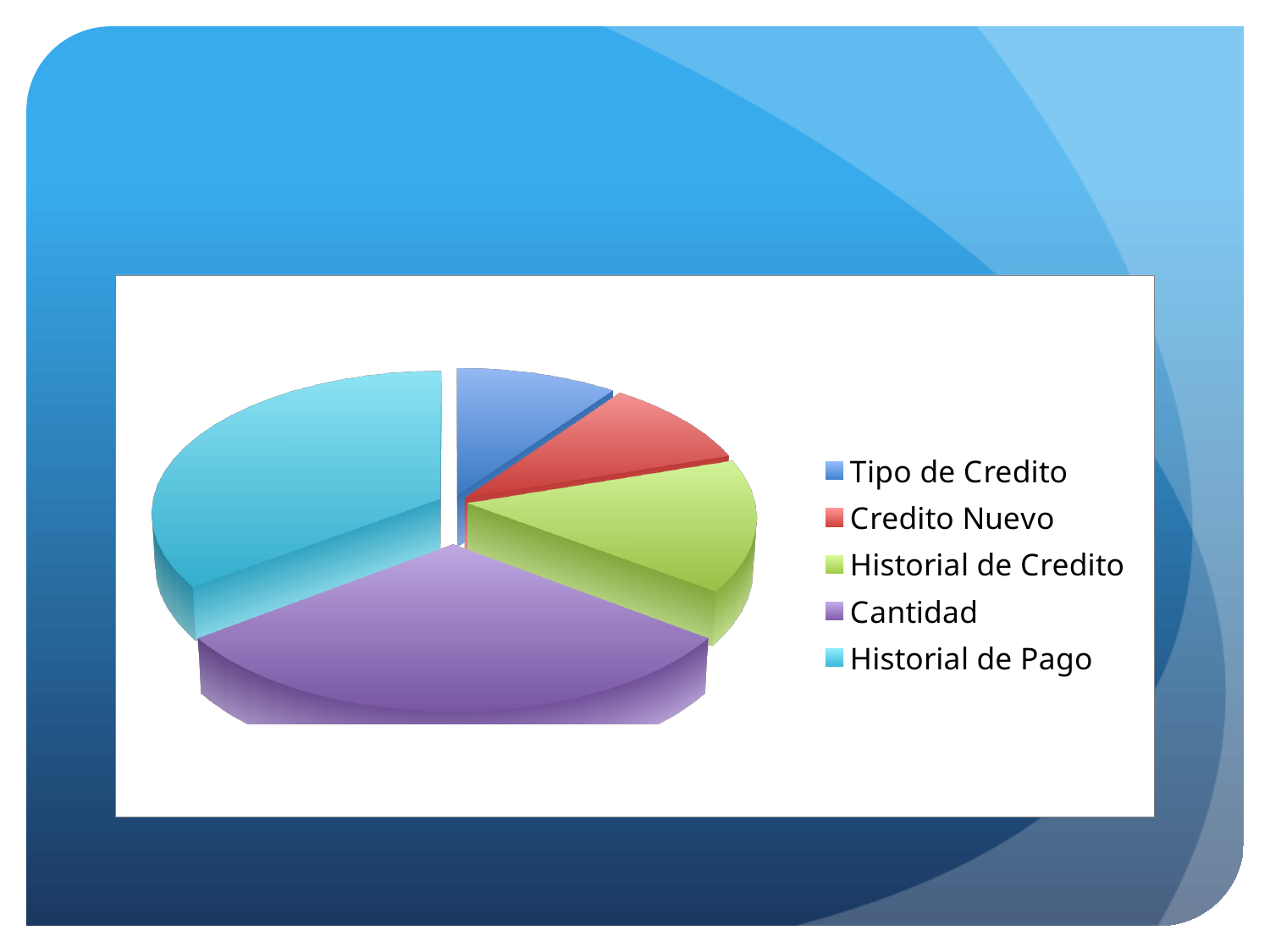
How many slices does the pie chart have? 5 What colour is the Cantidad slice in the pie chart? Purple Which slice is larger, Historial de Pago or Tipo de Credito? Historial de Pago Which slice is larger, Cantidad or Historial de Credito? Cantidad Which slice is larger, Historial de Credito or Tipo de Credito? Historial de Credito Which category is listed first in the pie chart's legend? Tipo de Credito How many entries does the legend of the pie chart list? 5 Which category has the largest slice in the pie chart? Historial de Pago What kind of chart is shown on the slide? Pie chart